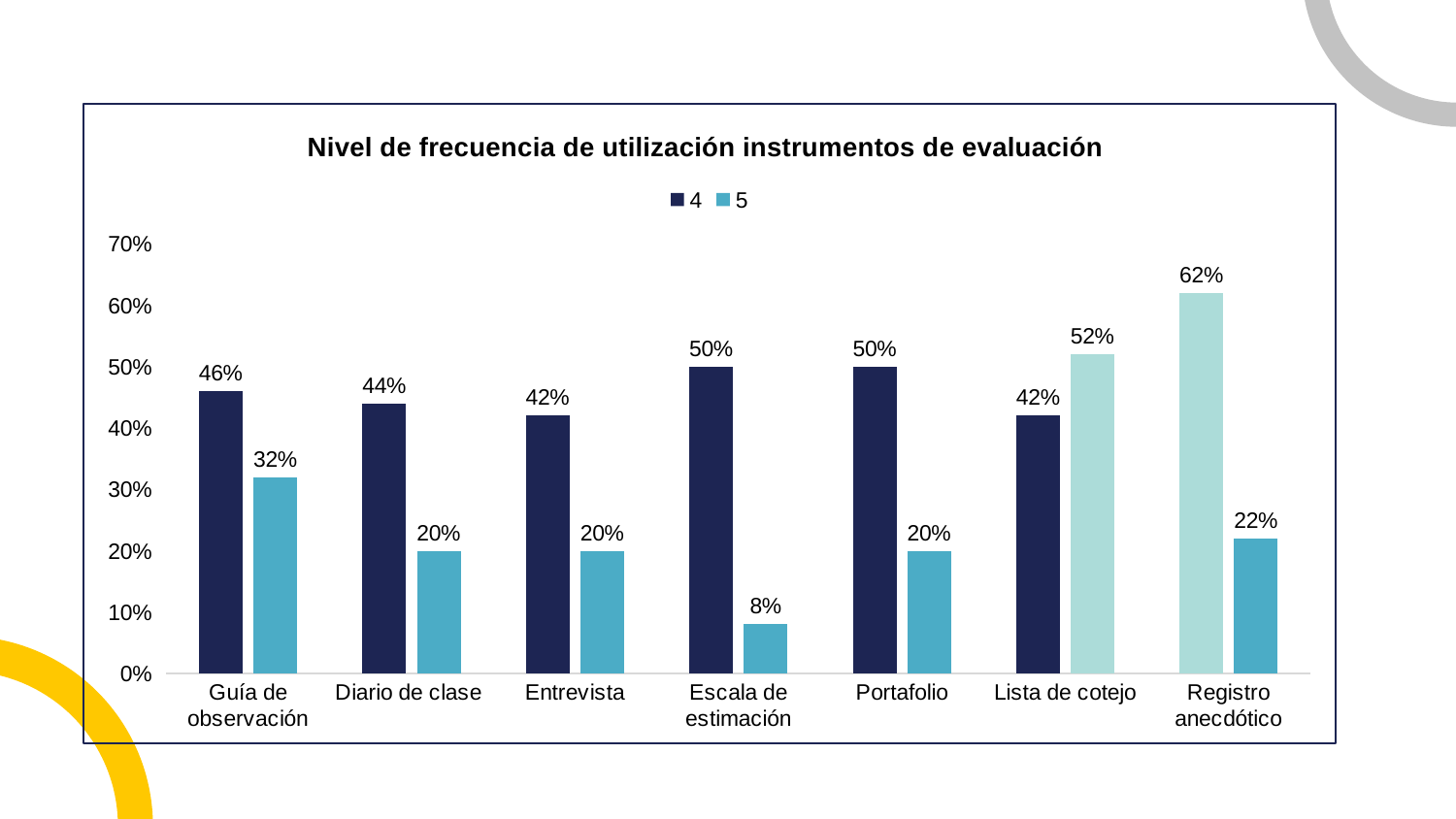
Which is larger for Guía de observación: the series 4 value or the series 5 value? series 4 How many series does the legend list? 2 What is the value for series 5 for Registro anecdótico? 22% What kind of chart is this? bar chart How many categories are shown on the x axis? 7 Which category has the lowest value for series 5? Escala de estimación What is the title of the chart? Nivel de frecuencia de utilización instrumentos de evaluación What is the difference between the series 4 and series 5 values for Escala de estimación? 42% What is the value for series 4 for Guía de observación? 46% Which category has the highest bar in the chart? Registro anecdótico What is the value for series 4 for Lista de cotejo? 42% What is the value for series 5 for Escala de estimación? 8%